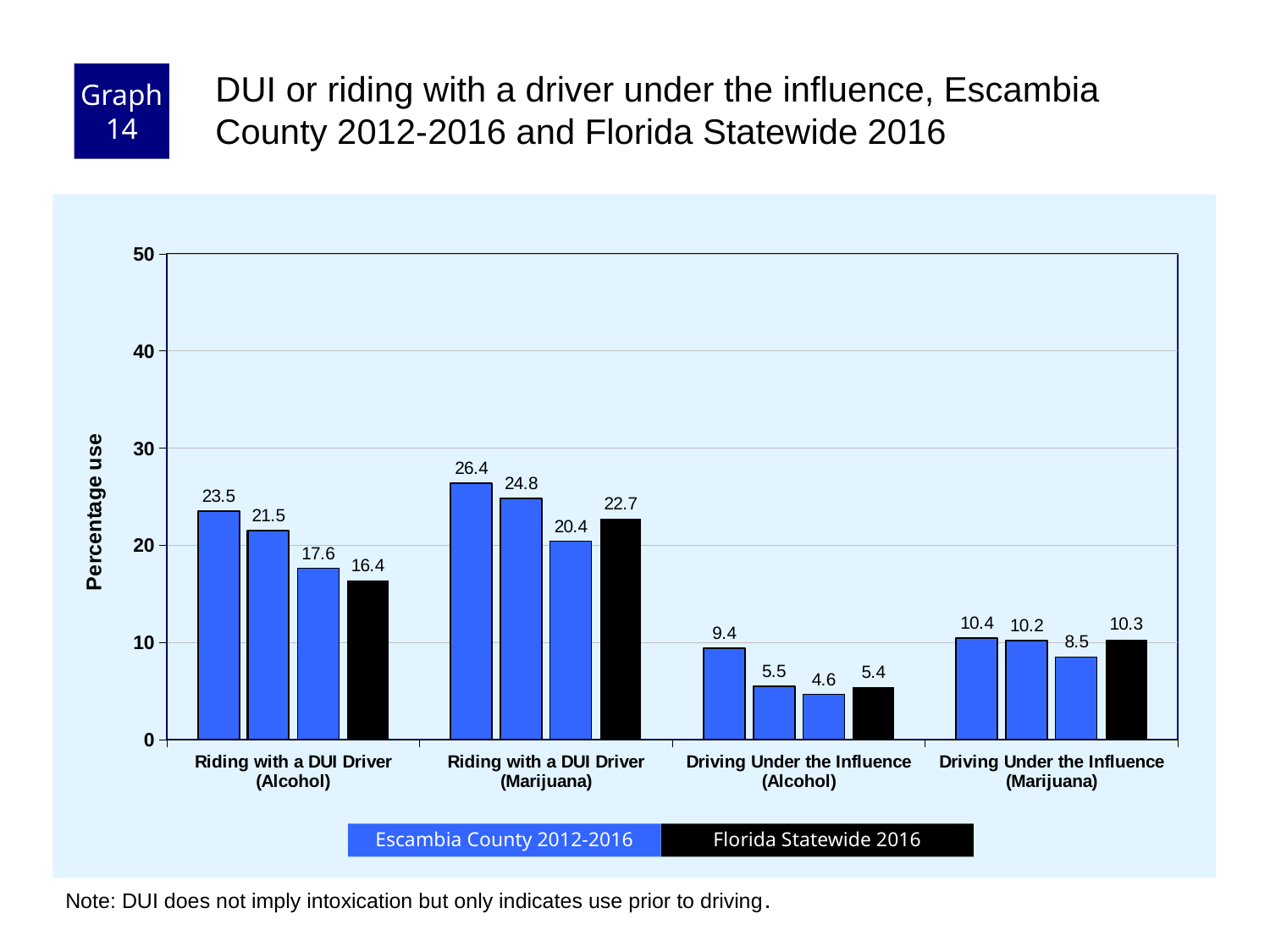
What is the Florida Statewide 2016 value for Riding with a DUI Driver (Alcohol)? 16.4 Is the Florida Statewide 2016 value for Riding with a DUI Driver (Marijuana) greater or less than 20? greater Which category has the highest Florida Statewide 2016 value? Riding with a DUI Driver (Marijuana) How many categories are shown on the x axis? 4 What kind of chart is shown on the slide? bar chart In the Riding with a DUI Driver (Marijuana) group, what is the difference between the first Escambia County bar (26.4) and the Florida Statewide 2016 bar? 3.7 What is the value of the tallest bar in the Riding with a DUI Driver (Marijuana) group? 26.4 What is the Florida Statewide 2016 value for Driving Under the Influence (Marijuana)? 10.3 Which is larger: the Florida Statewide 2016 value for Riding with a DUI Driver (Alcohol) or for Driving Under the Influence (Marijuana)? Riding with a DUI Driver (Alcohol) Which category has the lowest Florida Statewide 2016 value? Driving Under the Influence (Alcohol) How many series does the legend list? 2 Within the Riding with a DUI Driver (Alcohol) group, do the Escambia County bars rise or fall from left to right? fall